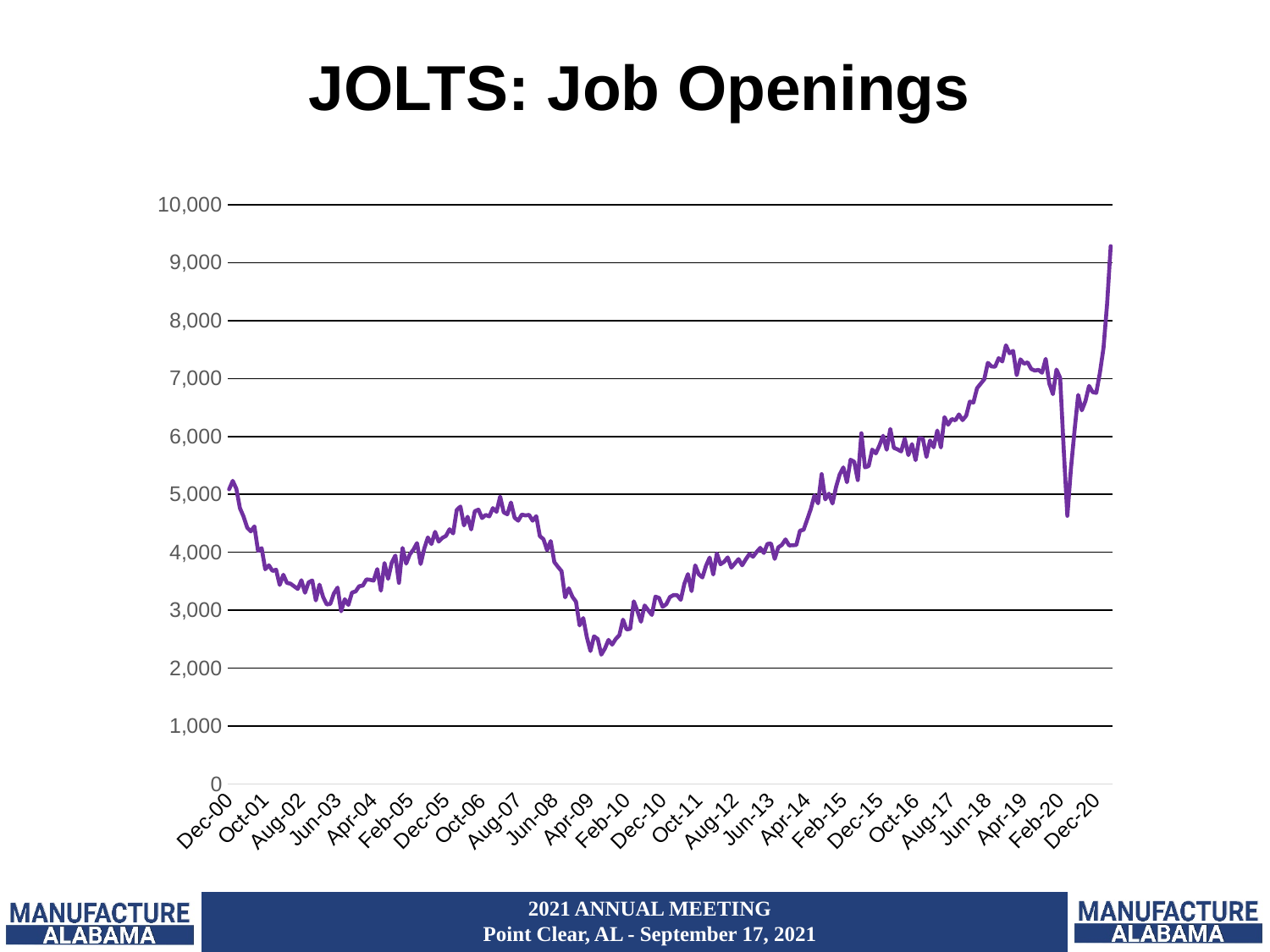
What is the highest value shown on the vertical axis of the chart? 10,000 Is the value for Aug-07 greater or less than 4,000? greater How many lines (data series) are plotted on the chart? 1 Is the value for Oct-16 greater or less than 5,000? greater Is the value for Apr-09 greater or less than 3,000? less Does the line rise or fall between Apr-09 and Feb-15? rise Which has the larger value, Dec-00 or Dec-20? Dec-20 What type of chart is shown on the slide? line chart Does the line reach its highest value at the start or at the end of the series? end What is the title of the chart? JOLTS: Job Openings